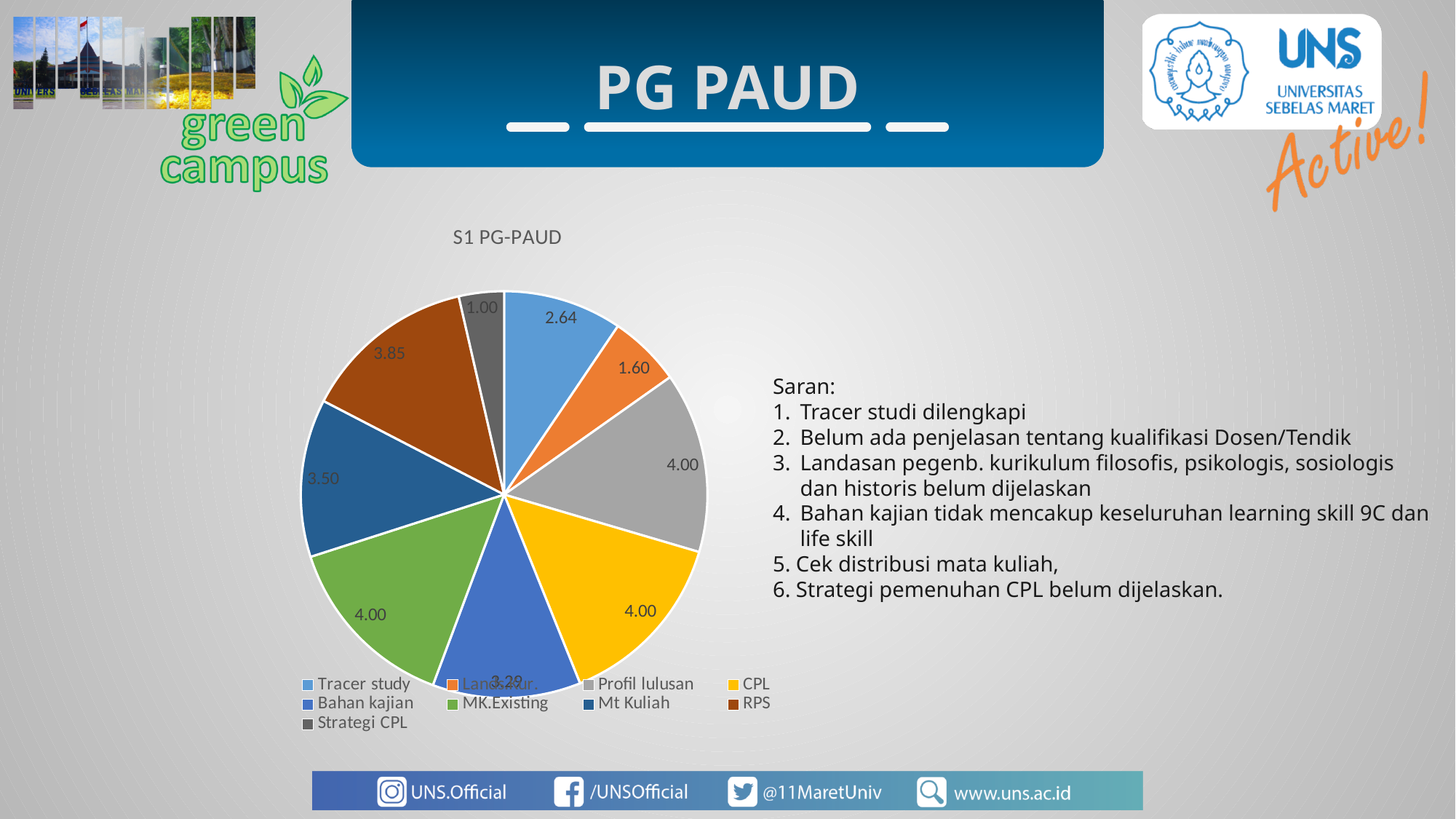
What is the value for Strategi CPL? 1.00 What colour is the CPL slice? Yellow What is the value for Bahan kajian? 3.29 Which category has the smallest slice? Strategi CPL What is the difference between the values for RPS and Mt Kuliah? 0.35 How many slices does the pie chart have? 9 Which is larger, the value for Tracer study or the value for Bahan kajian? Bahan kajian What is the title of the chart? S1 PG-PAUD What is the value for Mt Kuliah? 3.50 What is the value for Tracer study? 2.64 What is the value for RPS? 3.85 What kind of chart is shown on the slide? Pie chart